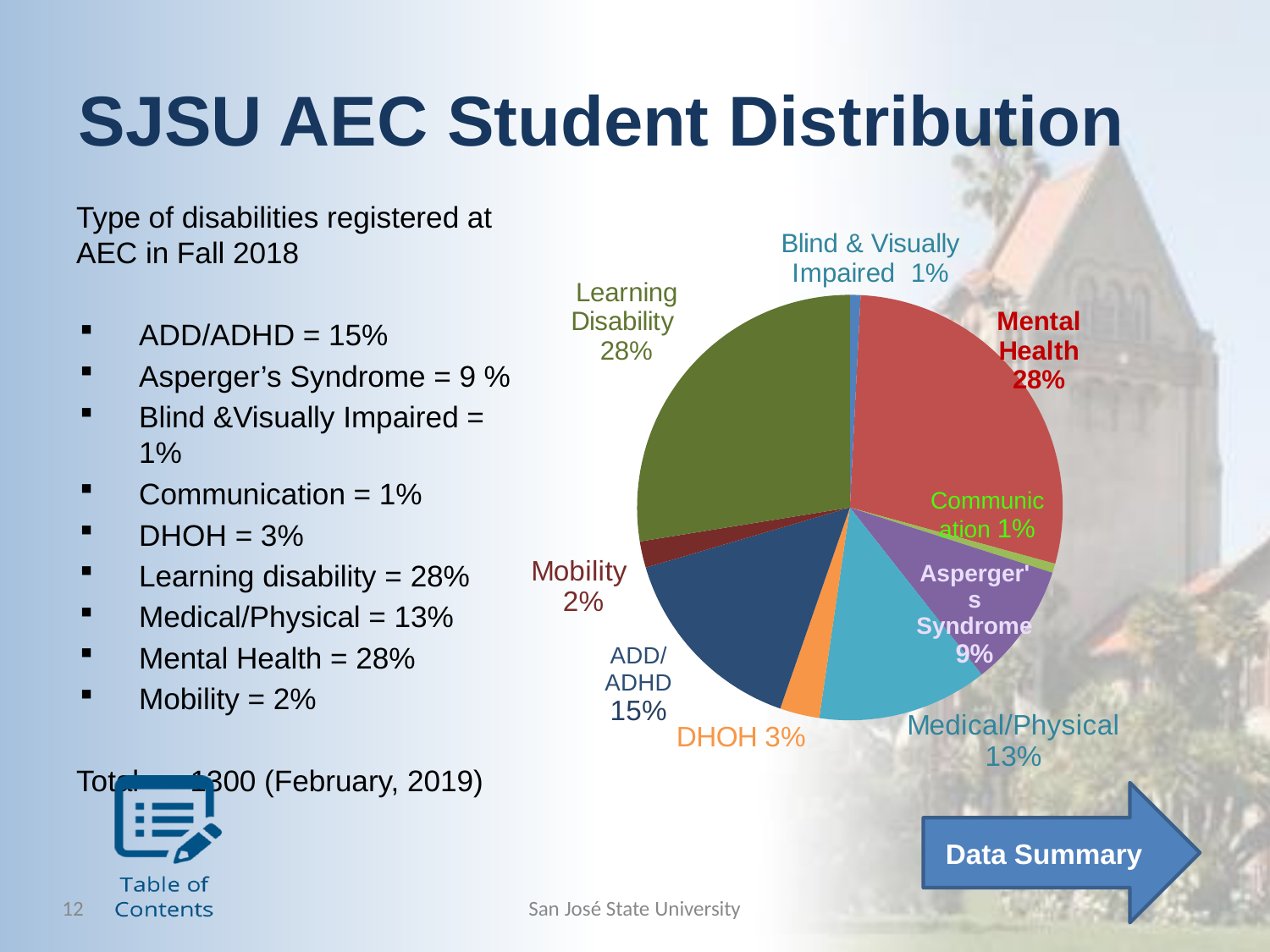
What is the difference in percentage points between Learning Disability and Asperger's Syndrome? 19 What percentage is shown for DHOH? 3% What percentage is shown for Mobility? 2% Which is larger, the share for ADD/ADHD or the share for Medical/Physical? ADD/ADHD What colour is the Learning Disability slice of the pie chart? green What type of chart is shown on the slide? pie chart What is the difference in percentage points between Medical/Physical and DHOH? 10 What percentage is shown for Medical/Physical? 13% What percentage is shown for ADD/ADHD? 15% What share of the pie does Mental Health represent? 28% How many slices does the pie chart have? 9 What percentage is shown for Asperger's Syndrome? 9%